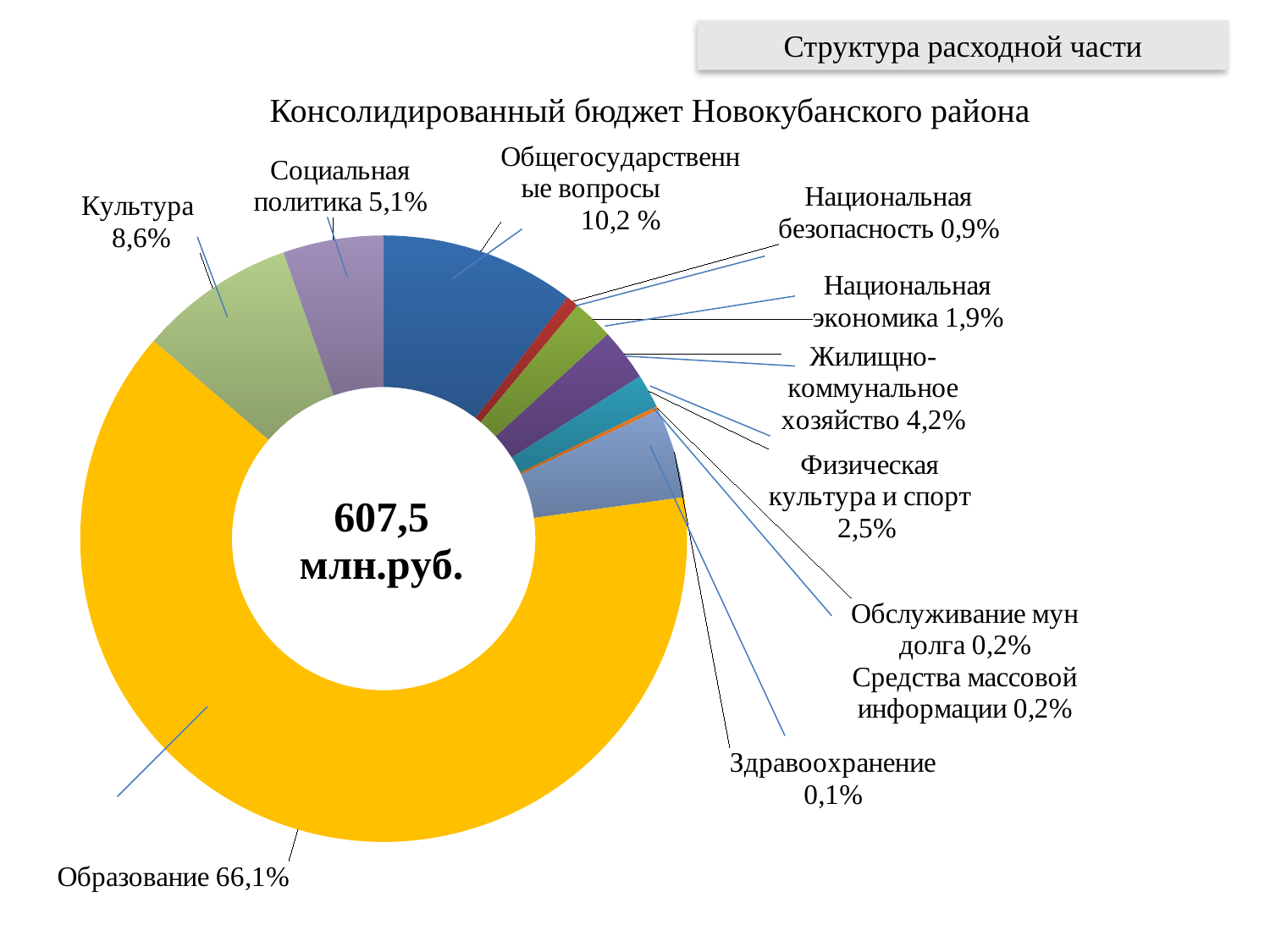
What kind of chart is shown on the slide? Doughnut chart What share of the budget goes to Национальная безопасность? 0,9% Which has a larger share, Физическая культура и спорт or Национальная экономика? Физическая культура и спорт What total value is shown in the centre of the chart? 607,5 млн.руб. What is the title of the chart? Консолидированный бюджет Новокубанского района Which category has the largest share of the budget? Образование What share of the budget goes to Общегосударственные вопросы? 10,2 % How many categories are shown in the chart? 11 What share of the budget goes to Жилищно-коммунальное хозяйство? 4,2% What is the difference in percentage points between Культура and Социальная политика? 3,5 Which category has the smallest share of the budget? Здравоохранение What share of the budget goes to Образование? 66,1%